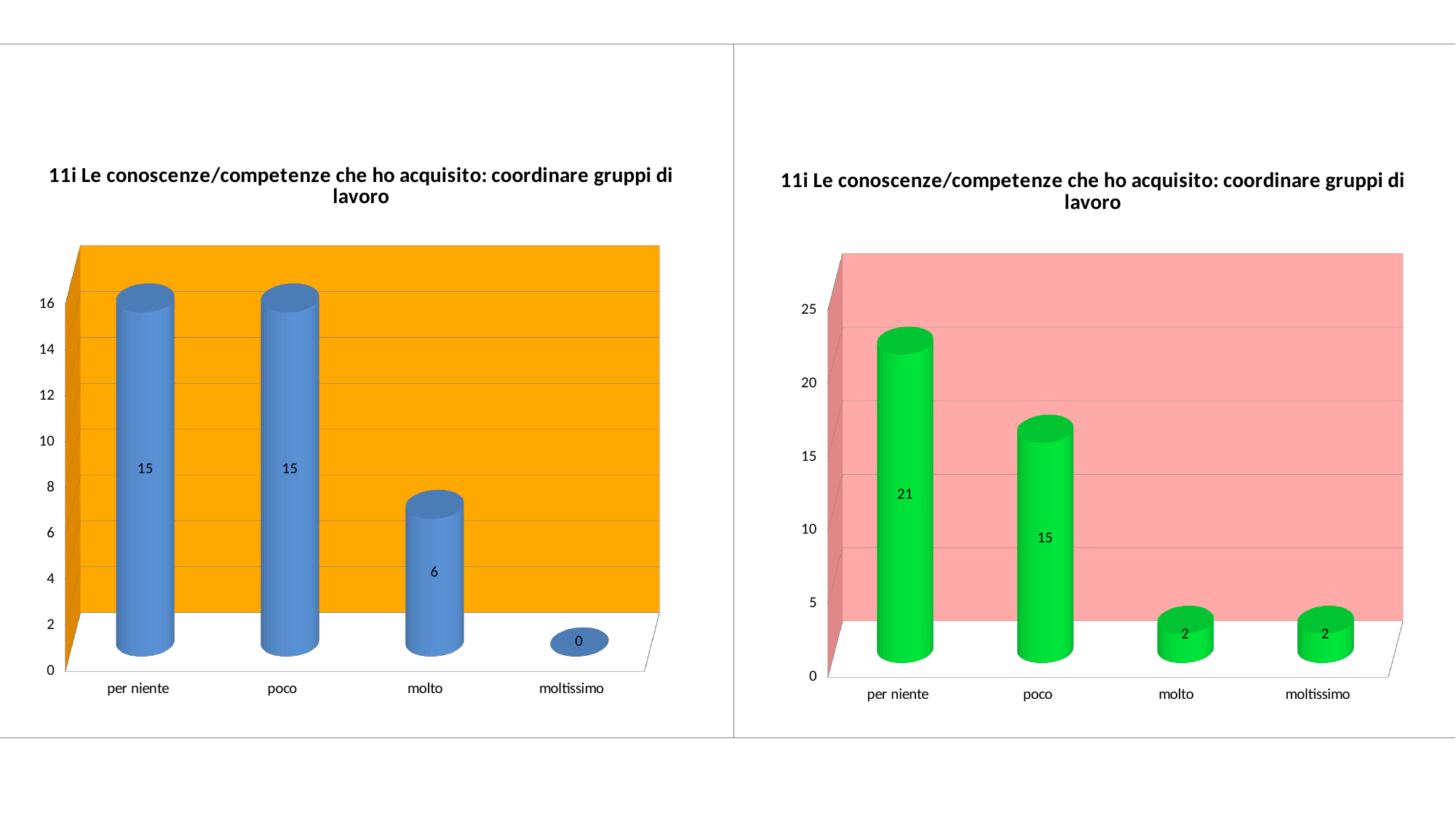
How many categories are shown on the x axis of the left chart? 4 What colour are the bars in the right chart? green In the right chart, what is the value for per niente? 21 In the left chart, what is the value for moltissimo? 0 In the left chart, which category has the lowest value? moltissimo What kind of chart is the right chart? bar chart In the left chart, what is the value for molto? 6 In the right chart, what is the value for poco? 15 In the left chart, what is the difference between the values for poco and molto? 9 In the right chart, what is the difference between the values for per niente and poco? 6 In the right chart, which is larger, the value for molto or the value for poco? poco In the right chart, which category has the highest value? per niente